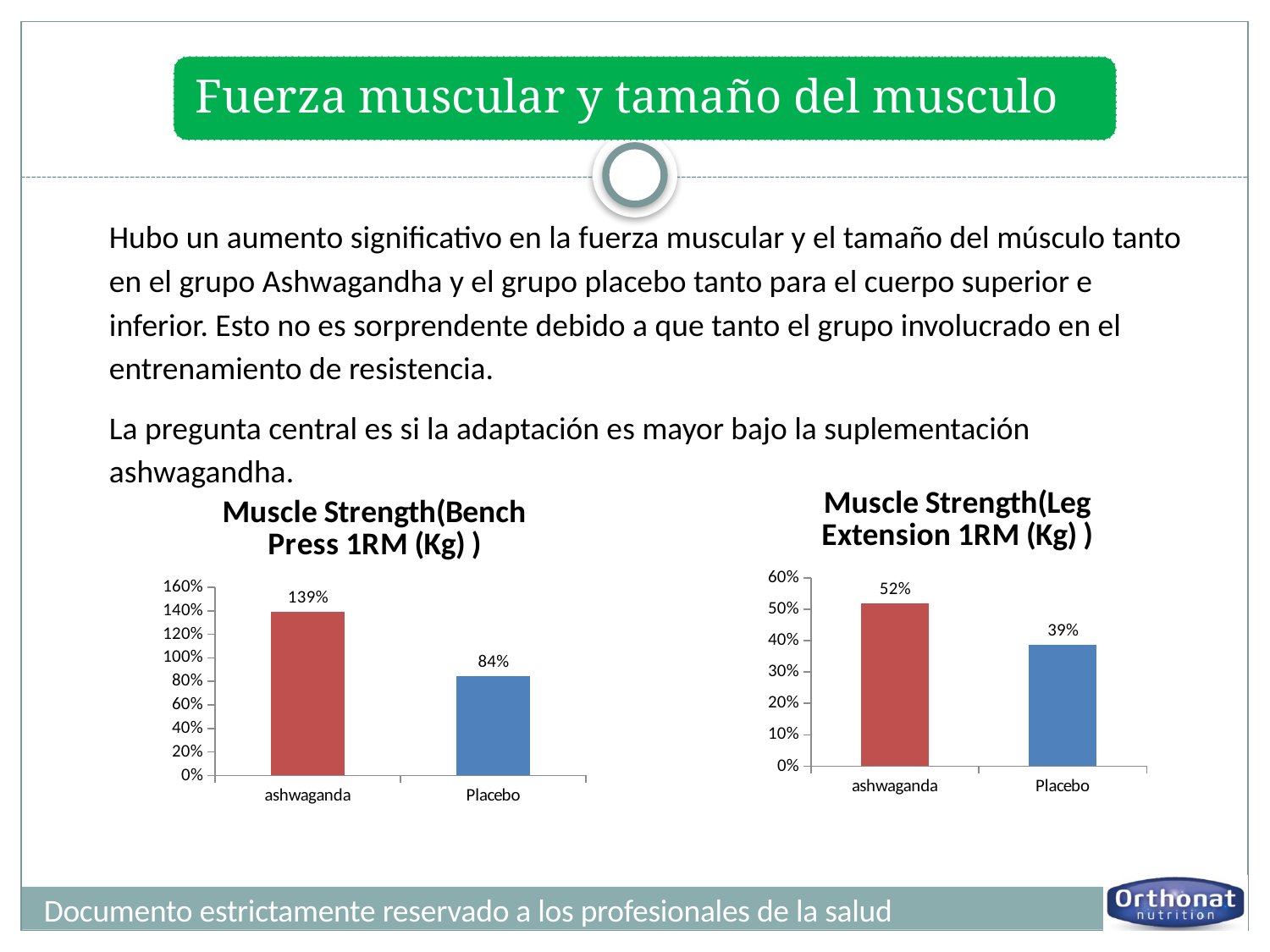
In the Muscle Strength (Leg Extension 1RM (Kg)) chart, what is the difference between the ashwaganda and Placebo values? 13% In the Muscle Strength (Leg Extension 1RM (Kg)) chart, what is the value for ashwaganda? 52% In the Muscle Strength (Bench Press 1RM (Kg)) chart, what is the value for ashwaganda? 139% In the Muscle Strength (Leg Extension 1RM (Kg)) chart, which is larger, ashwaganda or Placebo? ashwaganda In the Muscle Strength (Bench Press 1RM (Kg)) chart, what is the value for Placebo? 84% How many categories are shown in the Muscle Strength (Leg Extension 1RM (Kg)) chart? 2 In the Muscle Strength (Bench Press 1RM (Kg)) chart, what is the difference between the ashwaganda and Placebo values? 55% In the Muscle Strength (Leg Extension 1RM (Kg)) chart, what is the value for Placebo? 39% What kind of chart is the Muscle Strength (Bench Press 1RM (Kg)) chart? bar chart In the Muscle Strength (Leg Extension 1RM (Kg)) chart, which category has the lowest value? Placebo In the Muscle Strength (Bench Press 1RM (Kg)) chart, is the value for Placebo greater or less than 100%? less In the Muscle Strength (Bench Press 1RM (Kg)) chart, which category has the highest value? ashwaganda